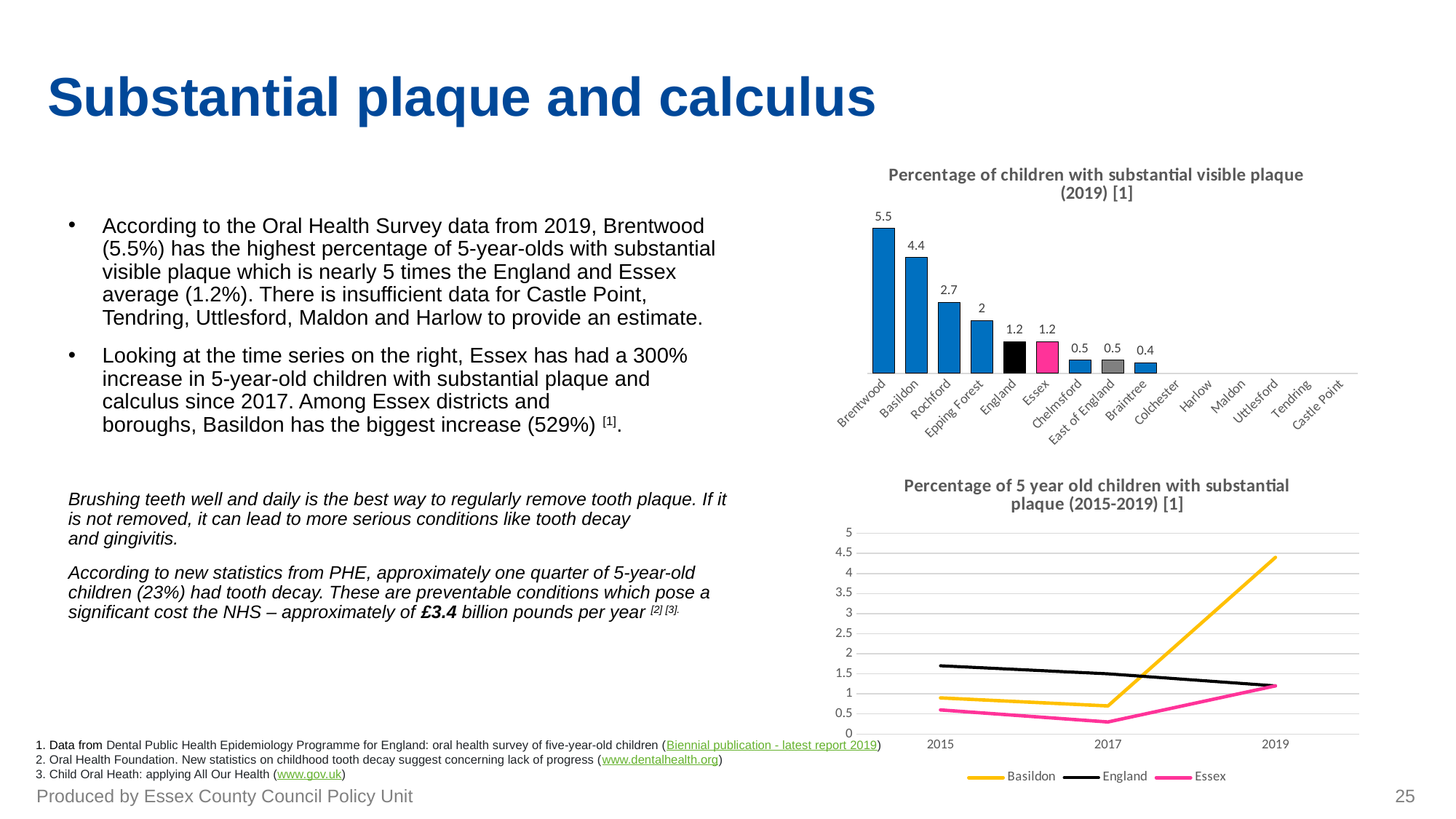
In the line chart 'Percentage of 5 year old children with substantial plaque (2015-2019)', is the value for Basildon in 2019 greater or less than 4? greater In the bar chart 'Percentage of children with substantial visible plaque (2019)', what is the difference between Brentwood and Basildon? 1.1 In the bar chart 'Percentage of children with substantial visible plaque (2019)', which is larger, Epping Forest or Chelmsford? Epping Forest How many categories are labelled on the x axis of the bar chart 'Percentage of children with substantial visible plaque (2019)'? 15 In the bar chart 'Percentage of children with substantial visible plaque (2019)', which category has the highest value? Brentwood In the bar chart 'Percentage of children with substantial visible plaque (2019)', what is the value for Braintree? 0.4 In the line chart 'Percentage of 5 year old children with substantial plaque (2015-2019)', which series is shown in yellow? Basildon How many series does the legend of the line chart 'Percentage of 5 year old children with substantial plaque (2015-2019)' list? 3 What kind of chart is 'Percentage of 5 year old children with substantial plaque (2015-2019)'? Line chart In the bar chart 'Percentage of children with substantial visible plaque (2019)', what is the value for Rochford? 2.7 In the bar chart 'Percentage of children with substantial visible plaque (2019)', what is the value for Brentwood? 5.5 In the line chart 'Percentage of 5 year old children with substantial plaque (2015-2019)', does the England series rise or fall from 2015 to 2019? Fall